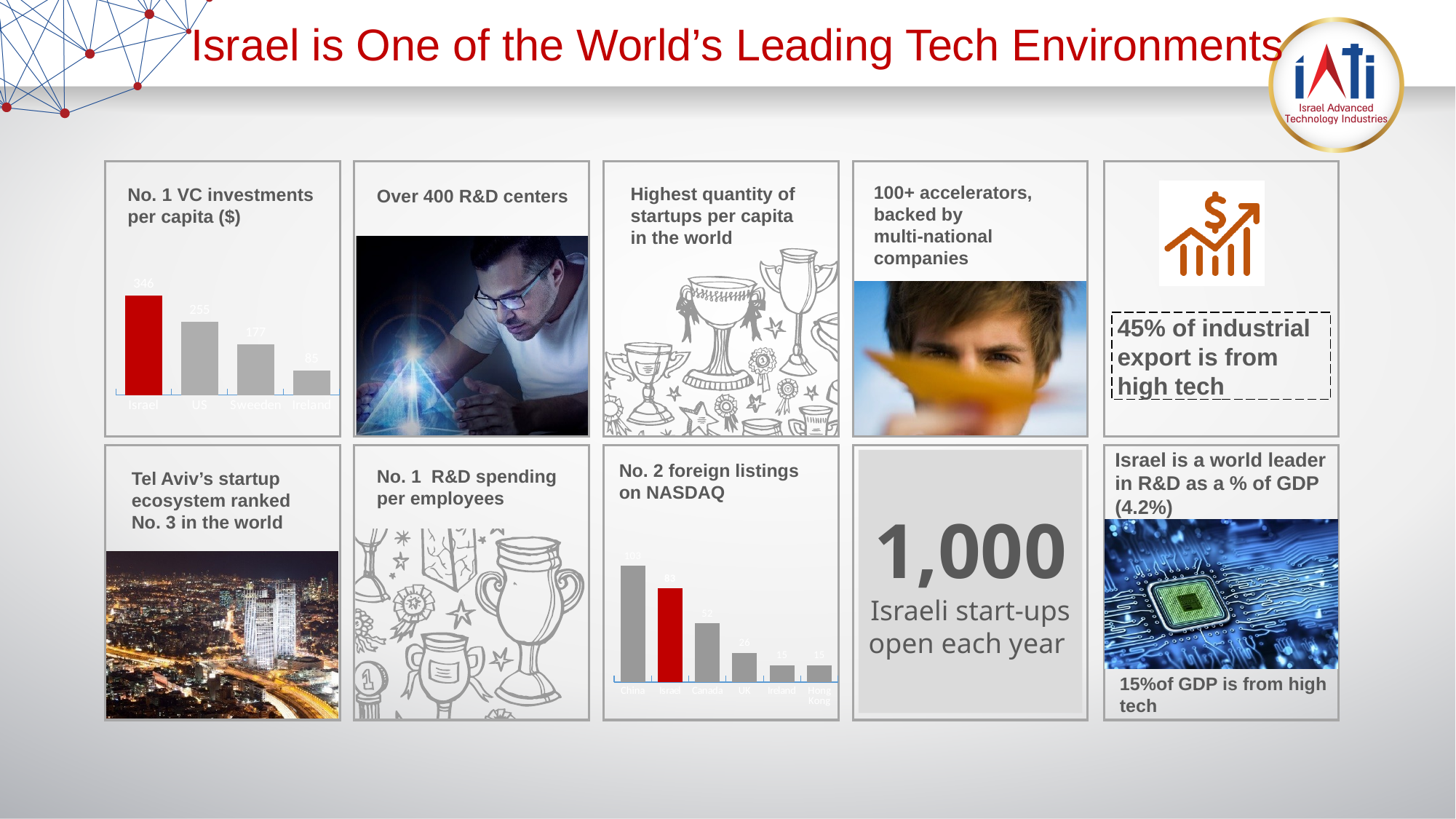
In the 'No. 2 foreign listings on NASDAQ' chart, what is the value for China? 103 In the 'No. 1 VC investments per capita ($)' chart, what is the difference between Israel and US? 91 In the 'No. 1 VC investments per capita ($)' chart, how many countries are shown? 4 In the 'No. 2 foreign listings on NASDAQ' chart, how many countries are shown? 6 In the 'No. 1 VC investments per capita ($)' chart, which country has the highest value? Israel In the 'No. 1 VC investments per capita ($)' chart, do the values rise or fall from left to right? fall In the 'No. 1 VC investments per capita ($)' chart, what is the value for Israel? 346 What type of chart is the 'No. 2 foreign listings on NASDAQ' chart? bar chart In the 'No. 2 foreign listings on NASDAQ' chart, which is larger, Canada or UK? Canada In the 'No. 2 foreign listings on NASDAQ' chart, which country has the highest value? China In the 'No. 1 VC investments per capita ($)' chart, what is the value for Ireland? 85 In the 'No. 2 foreign listings on NASDAQ' chart, what is the value for Israel? 83